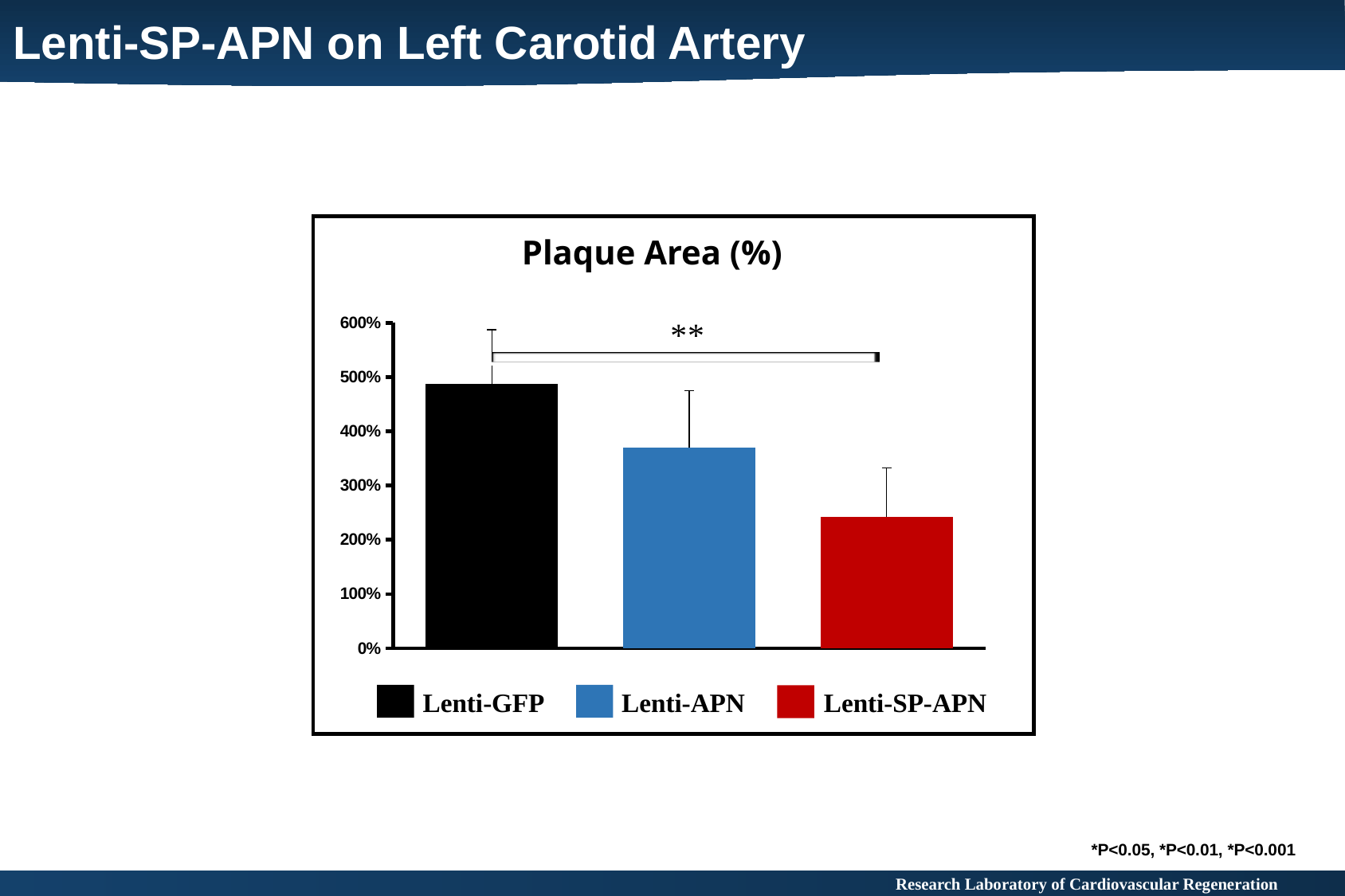
How many bars are plotted in the chart? 3 Do the bar values rise or fall from left to right across the chart? fall What colour is the Lenti-SP-APN bar? red Which has a larger plaque area, Lenti-APN or Lenti-SP-APN? Lenti-APN Is the value for Lenti-GFP greater or less than 400%? greater Is the value for Lenti-SP-APN greater or less than 300%? less Is the value for Lenti-APN greater or less than 300%? greater What kind of chart is shown on the slide? bar chart How many entries does the legend list? 3 What is the title of the chart? Plaque Area (%) Which group has the highest plaque area? Lenti-GFP Which group has the lowest plaque area? Lenti-SP-APN